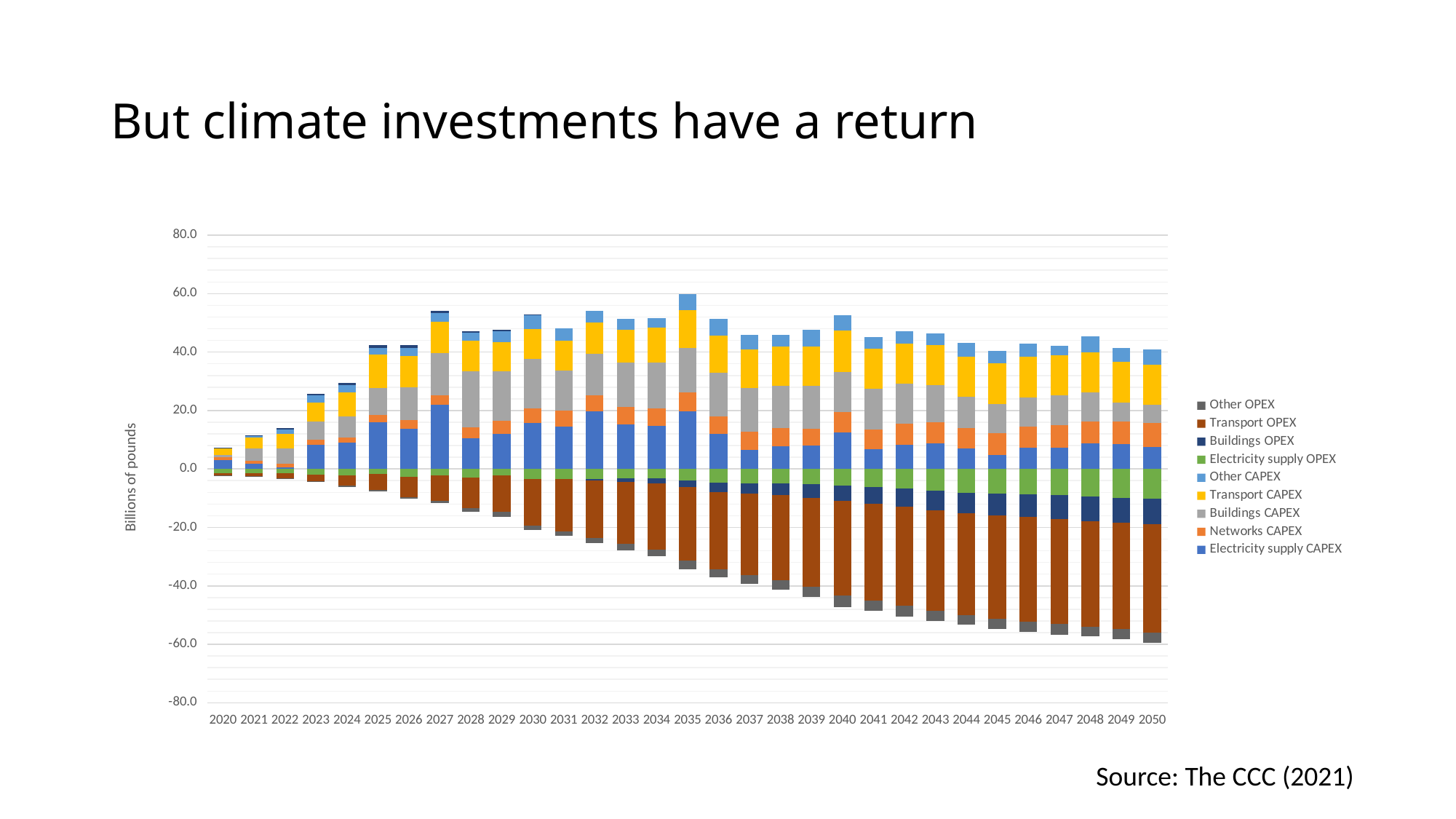
What is the first year shown on the x axis? 2020 Which year has the tallest positive (above zero) stacked bar? 2035 Is the bottom of the negative (below zero) stack for 2045 greater or less than -40? less How many years are shown along the x axis of the chart? 31 Is the total positive (above zero) stack for 2035 greater or less than 40? greater What kind of chart is shown on the slide? Stacked bar chart Is the bottom of the negative (below zero) stack for 2025 greater or less than -20? greater Does the negative (below zero) portion of the bars grow larger or smaller in magnitude from 2020 to 2050? larger What is the label on the vertical axis of the chart? Billions of pounds How many series does the chart's legend list? 9